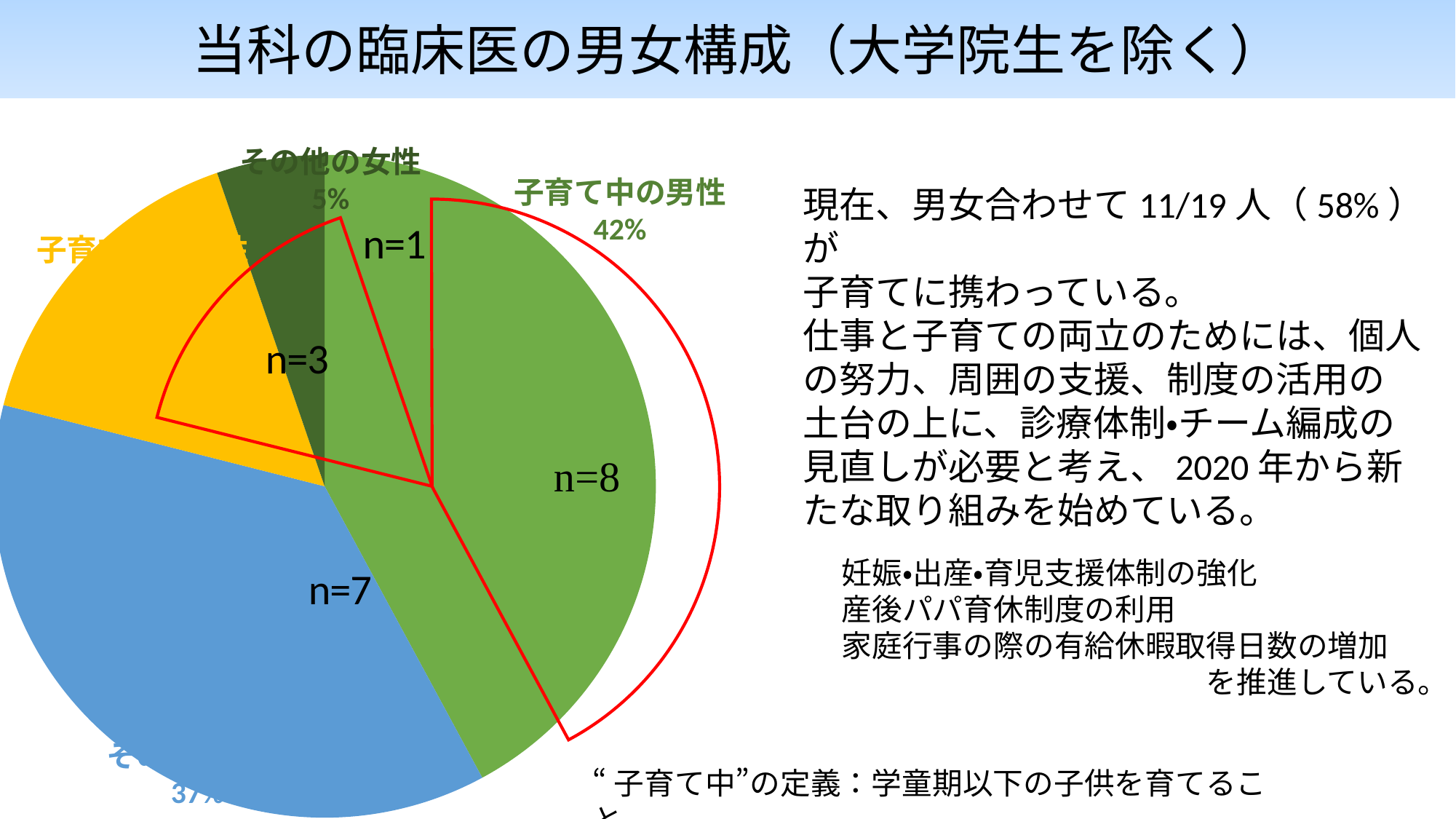
What is the n value shown on the blue slice of the pie? n=7 What is the n value shown on the yellow slice of the pie? n=3 What is the n value shown for the その他の女性 slice? n=1 How many slices does the pie chart have? 4 What share of the pie does その他の女性 represent? 5% What share of the pie does 子育て中の男性 represent? 42% What kind of chart is shown on the slide? pie chart What is the n value shown for the 子育て中の男性 slice? n=8 Which slice of the pie is the largest? 子育て中の男性 What is the difference in percentage points between the 子育て中の男性 slice and the その他の女性 slice? 37% Which slice of the pie is the smallest? その他の女性 What is the title of the slide containing the pie chart? 当科の臨床医の男女構成（大学院生を除く）